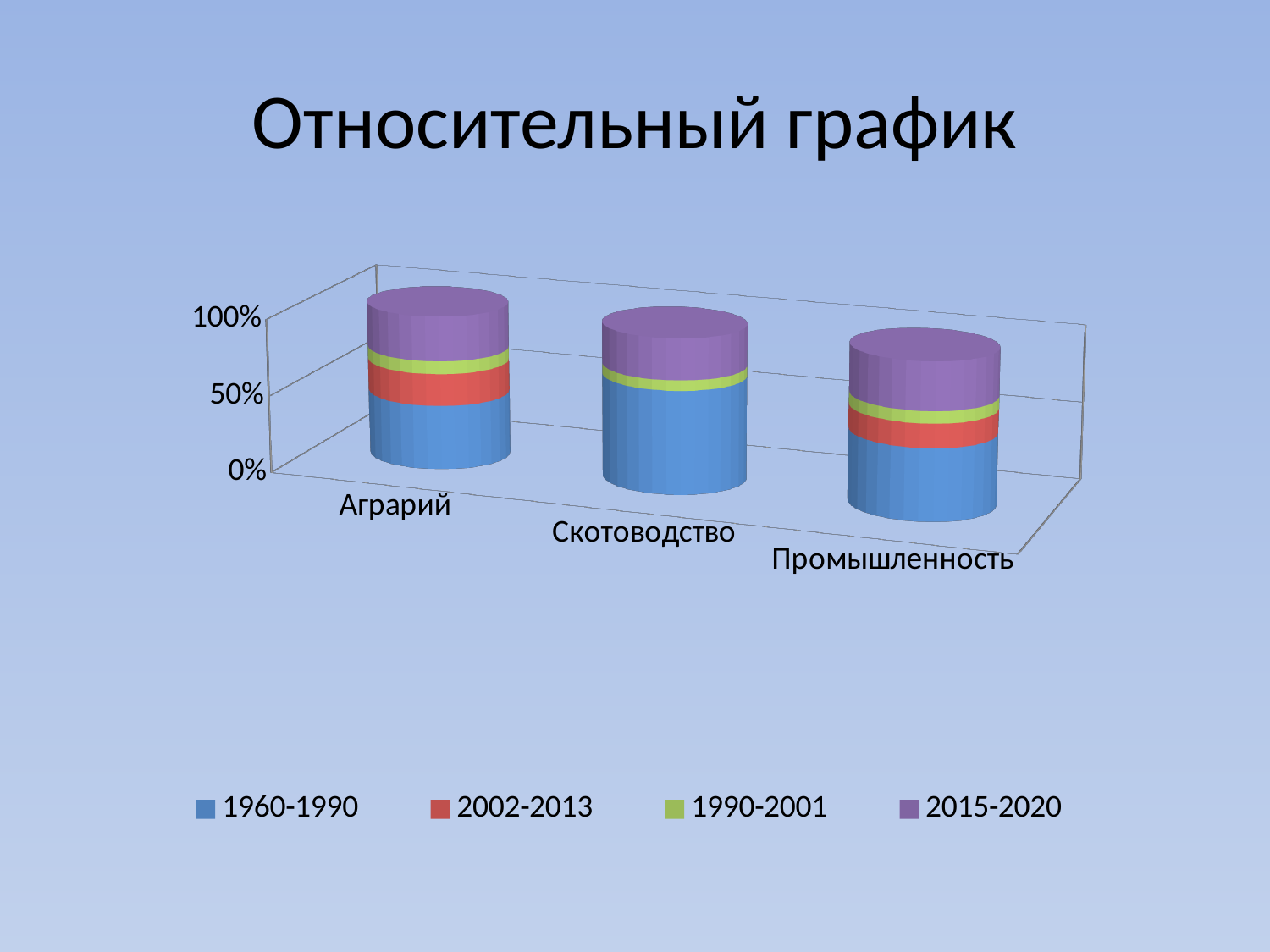
Is the 1960-1990 share larger for Скотоводство or for Промышленность? Скотоводство Which category has the smallest share for the 2002-2013 series? Скотоводство Which colour represents the 2015-2020 series in the legend? purple How many categories are shown on the x axis of the chart? 3 How many series does the legend list? 4 What kind of chart is shown on the slide? stacked bar chart Which category has the largest share for the 1960-1990 series? Скотоводство What is the title of the chart slide? Относительный график What is the highest value shown on the vertical axis? 100% What is the total of each stacked bar on this percentage chart? 100% Is the 2002-2013 share larger for Аграрий or for Скотоводство? Аграрий